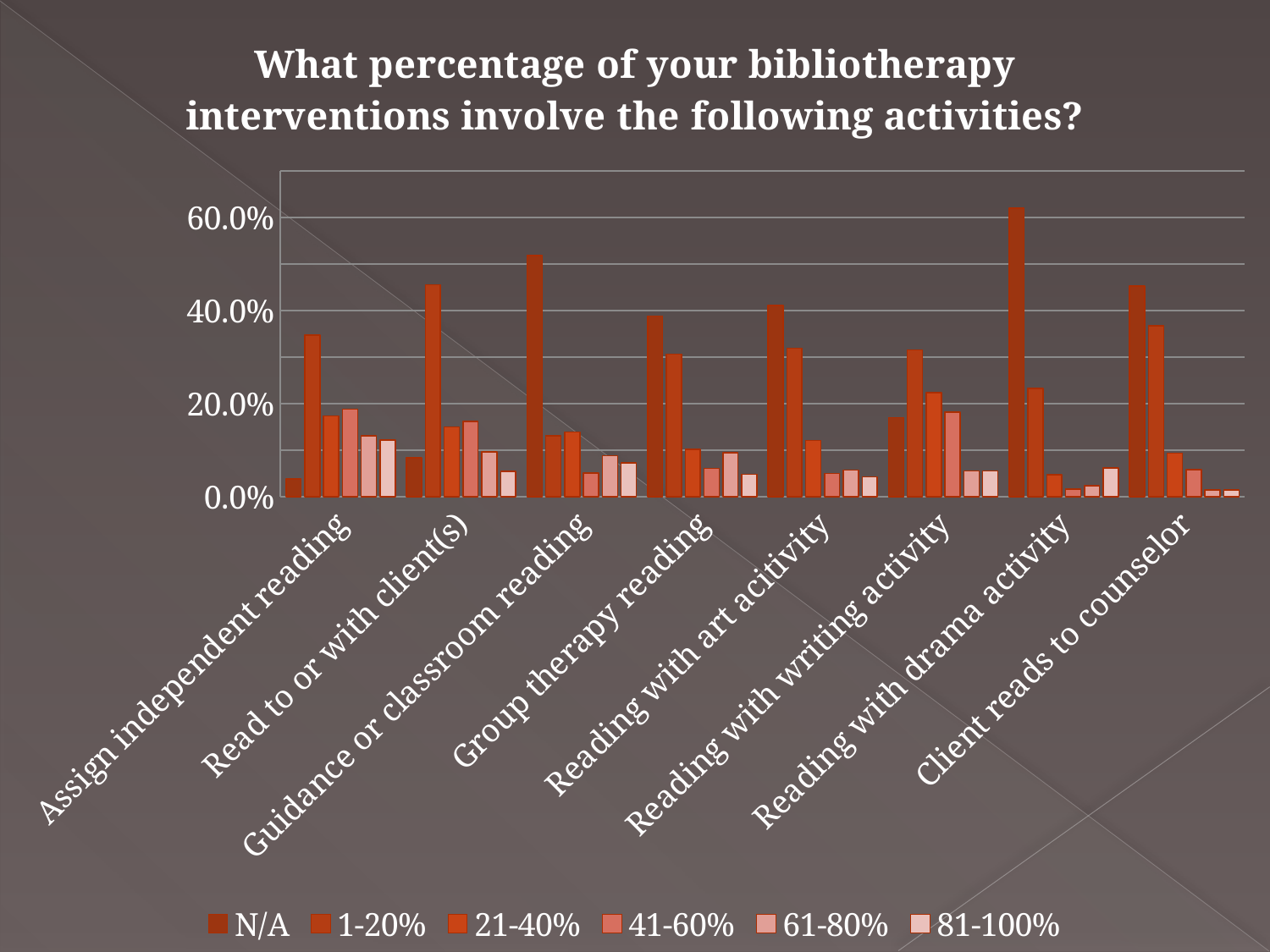
Which activity has the tallest N/A bar? Reading with drama activity Is the N/A value for Guidance or classroom reading greater or less than 40.0%? greater Which is larger: the N/A value for Guidance or classroom reading or the N/A value for Group therapy reading? Guidance or classroom reading Is the 1-20% value for Assign independent reading greater or less than 20.0%? greater Is the N/A value for Assign independent reading greater or less than 20.0%? less What is the first entry in the chart's legend? N/A How many series does the legend list? 6 For Assign independent reading, which series has the tallest bar? 1-20% What kind of chart is shown on the slide? bar chart Which activity has the shortest N/A bar? Assign independent reading How many activity categories are shown on the x axis? 8